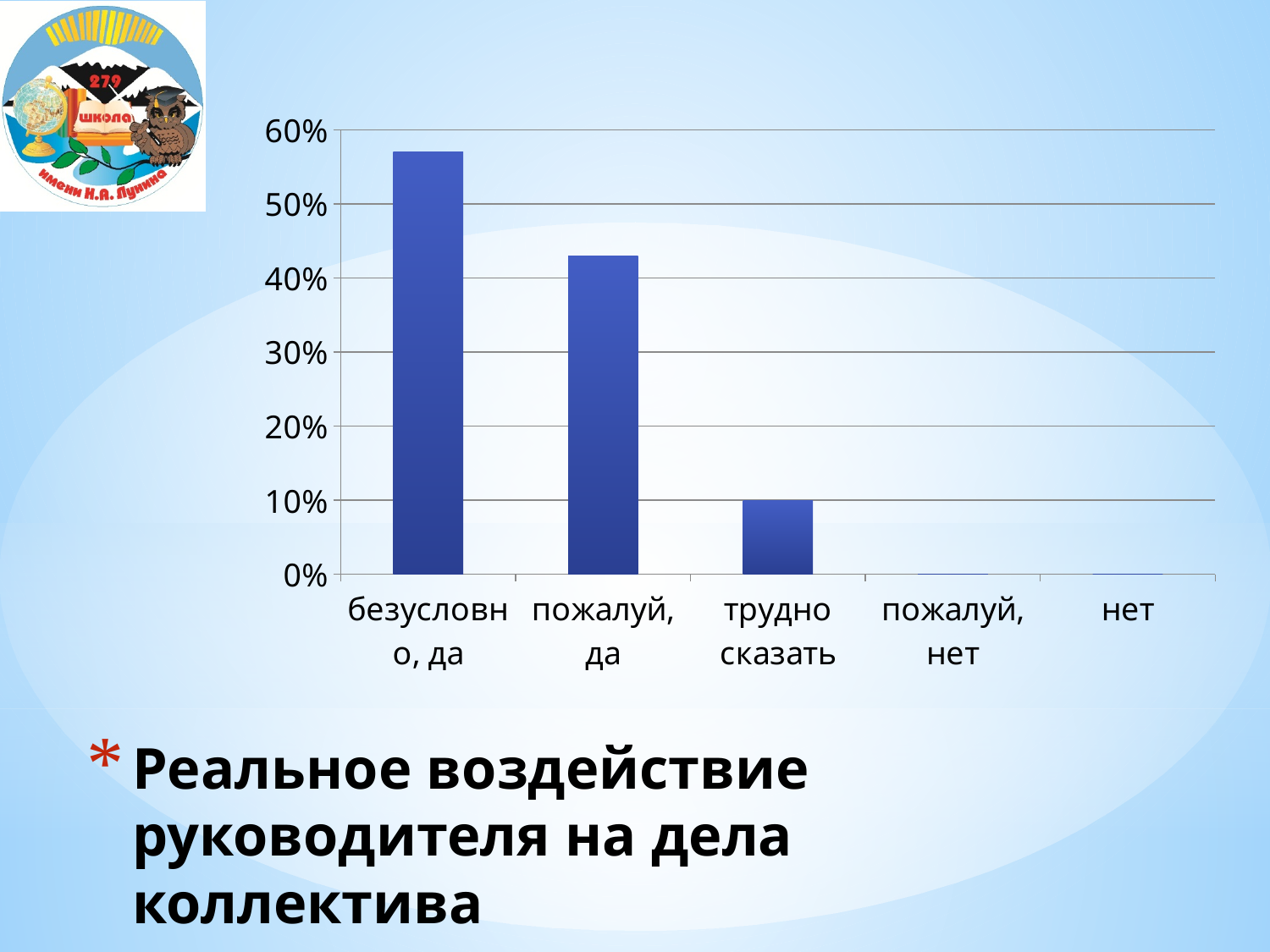
Do the bar values rise or fall moving from left to right along the x axis? fall What colour are the bars in the chart? blue Is the value for "пожалуй, нет" greater or less than 10%? less Is the value for "пожалуй, да" greater or less than 40%? greater Is the value for "нет" greater or less than 10%? less What is the value for "трудно сказать" in the chart? 10% How many categories are shown on the x axis of the chart? 5 Which category has the highest bar in the chart? безусловно, да What kind of chart is shown on the slide? bar chart Which is larger, the value for "безусловно, да" or the value for "пожалуй, да"? безусловно, да